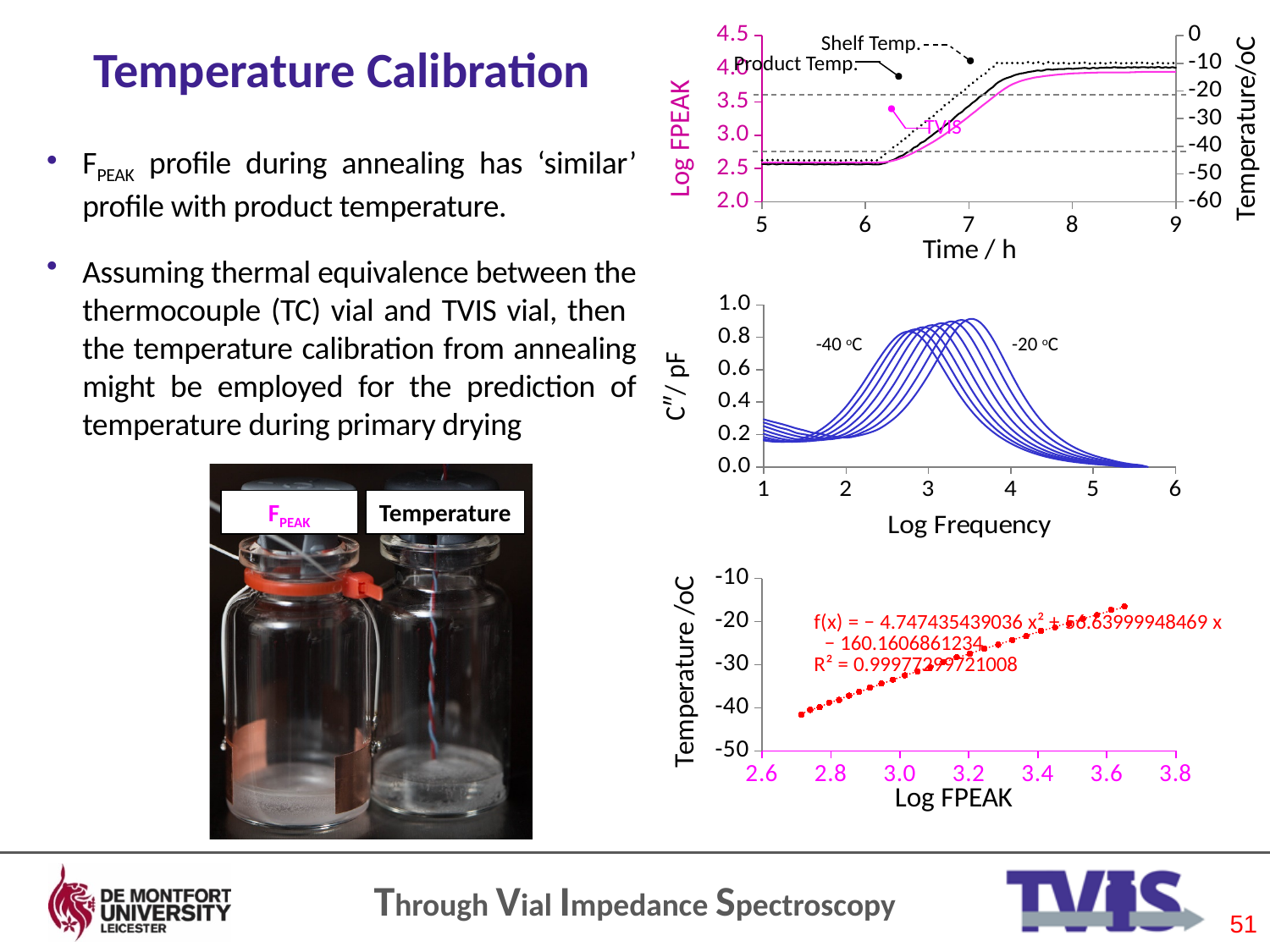
In the bottom chart, what R² value is printed for the fitted curve? R² = 0.99977299721008 In the bottom chart, does temperature rise or fall as Log FPEAK increases? rise What kind of chart is the bottom chart (Temperature /oC versus Log FPEAK)? scatter chart In the middle chart, is the highest peak of the curves greater or less than 1.0 pF? less What kind of chart is the middle chart (C''/ pF versus Log Frequency)? line chart In the top chart, what is the label of the x axis? Time / h In the top chart, is the Shelf Temp. value at 9 h greater or less than -20? greater In the top chart, do the Log FPEAK and temperature traces rise or fall as time increases from 6 h to 8 h? rise In the top chart, is the TVIS Log FPEAK value at 5 h greater or less than 3.0? less In the top chart, what is the label of the right-hand y axis? Temperature/oC What kind of chart is the top chart (Log FPEAK versus Time / h)? line chart In the middle chart, does the peak of the curves move to higher or lower Log Frequency as the temperature goes from -40 °C to -20 °C? higher